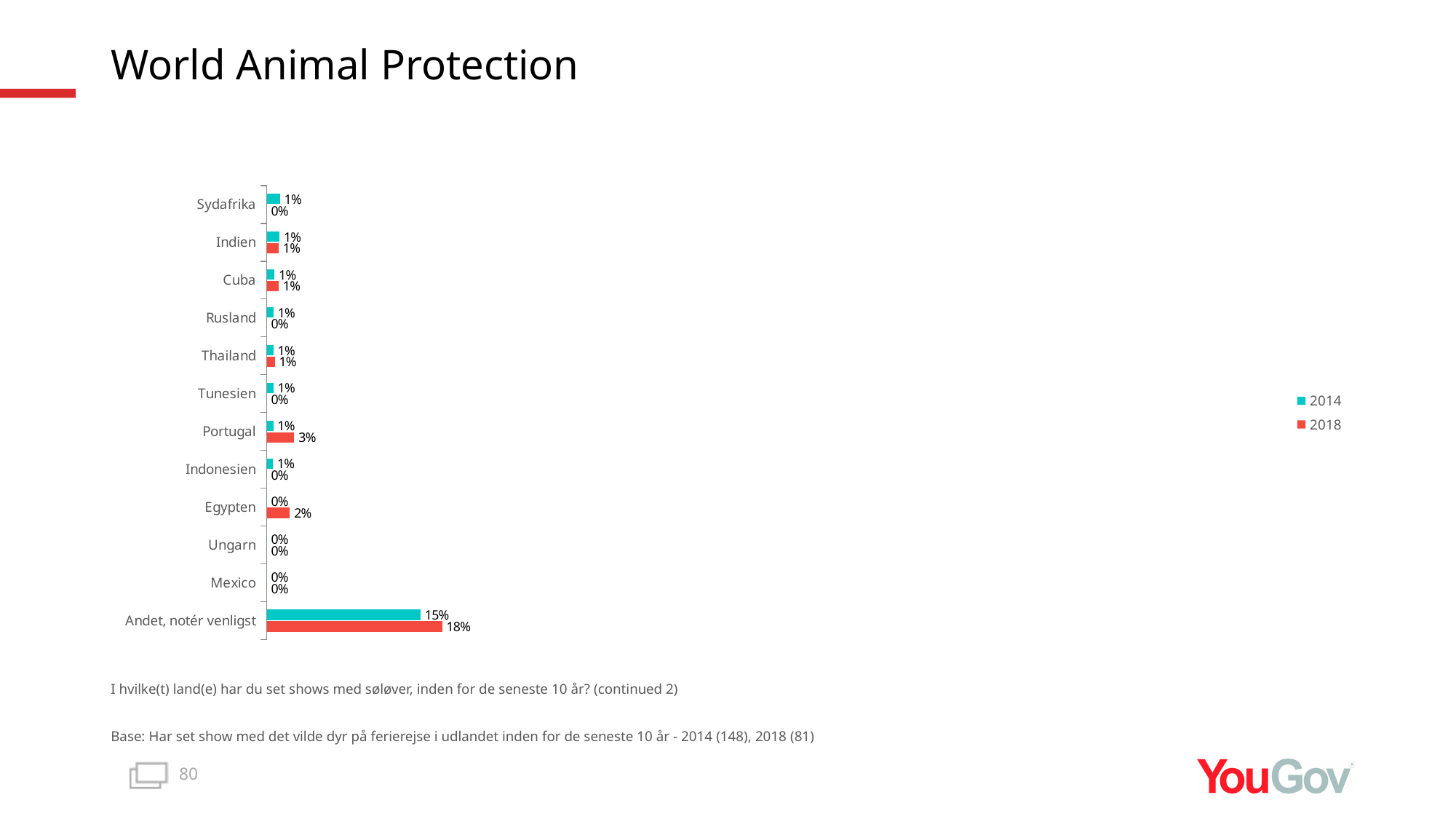
What is the difference between the 2018 and 2014 values for Andet, notér venligst? 3% Which category has the highest 2018 value? Andet, notér venligst What kind of chart is shown on the slide? Bar chart What is the 2018 value for Portugal? 3% What is the 2014 value for Andet, notér venligst? 15% Which is larger for Portugal, the 2014 value or the 2018 value? 2018 How many categories are shown on the chart? 12 How many series does the legend list? 2 Which series is shown in red in the legend? 2018 What is the 2014 value for Egypten? 0% What is the difference between the 2018 values for Portugal and Egypten? 1% What is the 2018 value for Egypten? 2%